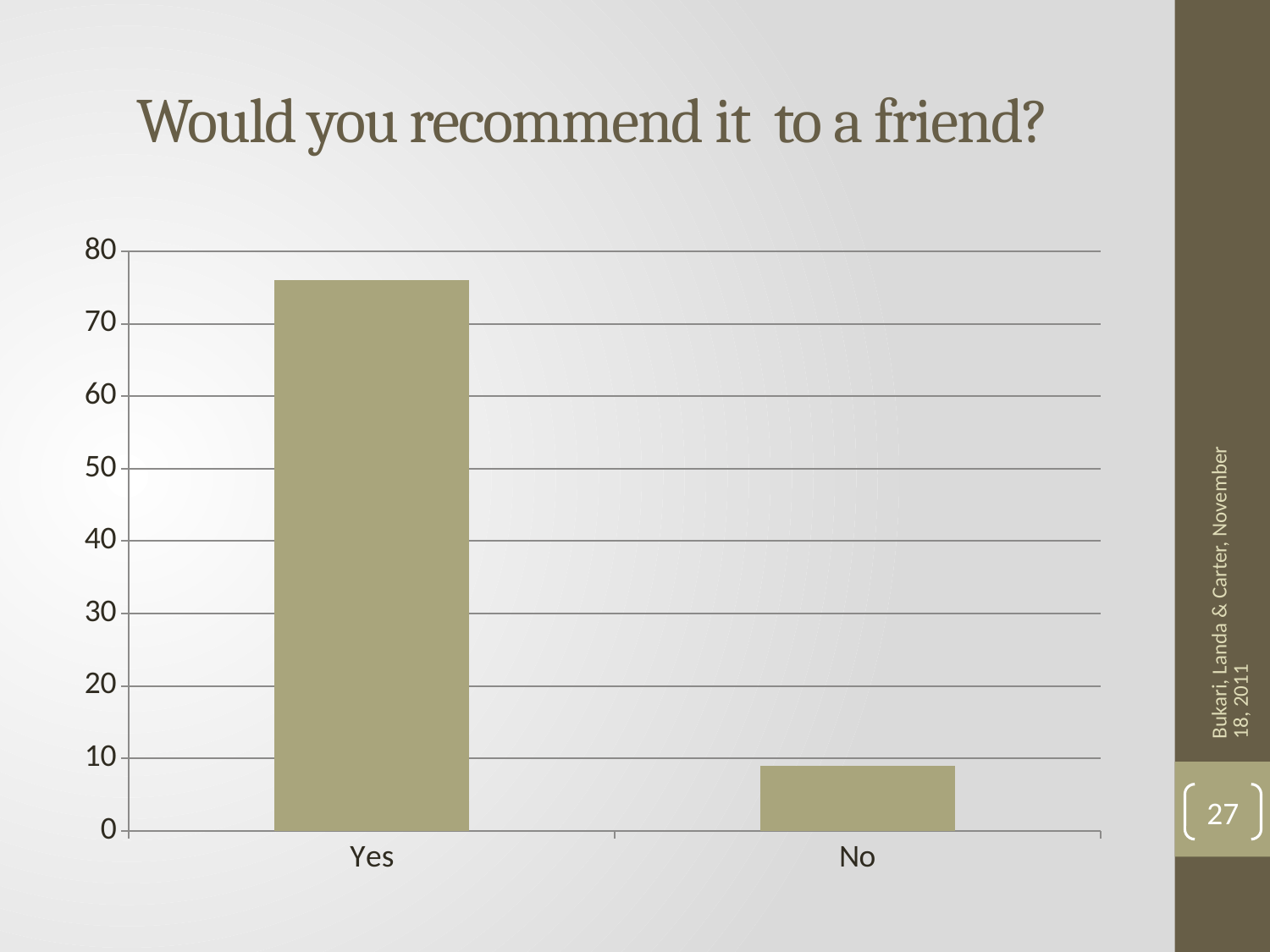
Which is larger, the value for Yes or the value for No? Yes What is the highest value shown on the chart's vertical axis? 80 Do the values rise or fall moving from Yes to No along the x axis? fall Which category has the lowest value in the chart? No Is the value for Yes greater or less than 70? greater Is the value for Yes greater or less than 50? greater What kind of chart is shown on the slide? bar chart How many categories are shown on the x axis of the chart? 2 Is the value for No greater or less than 20? less What is the title of the slide containing the chart? Would you recommend it to a friend? Which category has the highest value in the chart? Yes